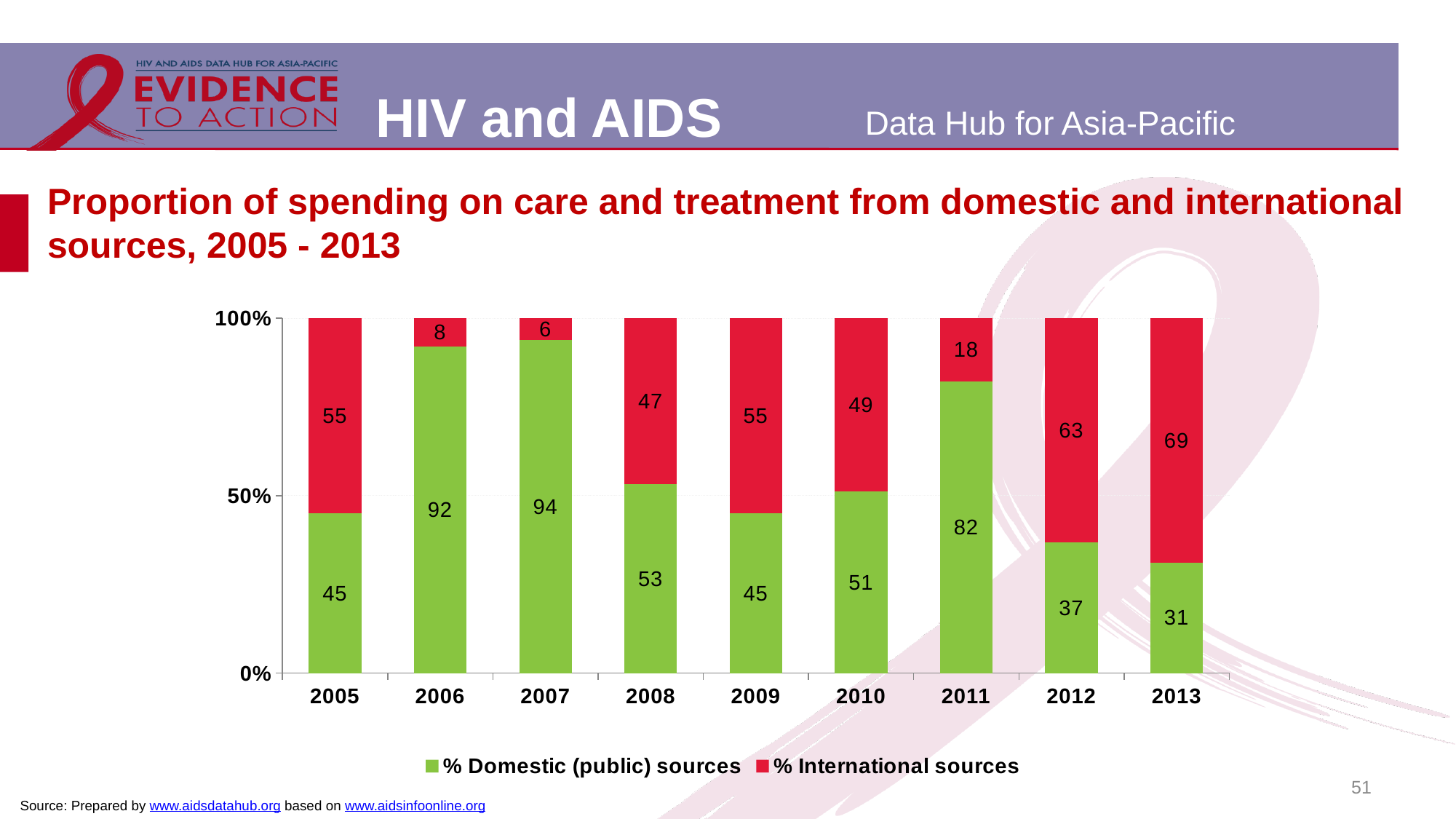
What is the value for % Domestic (public) sources in 2013? 31 What is the difference between the % Domestic (public) sources values for 2006 and 2012? 55 In which year is the % International sources value lowest? 2007 In which year is the % International sources value highest? 2013 How many years are shown on the x axis? 9 How many series does the legend list? 2 What kind of chart is shown on the slide? Stacked bar chart What is the value for % International sources in 2011? 18 What is the value for % Domestic (public) sources in 2008? 53 Which is larger in 2010: % Domestic (public) sources or % International sources? % Domestic (public) sources In which year is the % Domestic (public) sources value highest? 2007 Which colour represents % International sources in the chart? Red